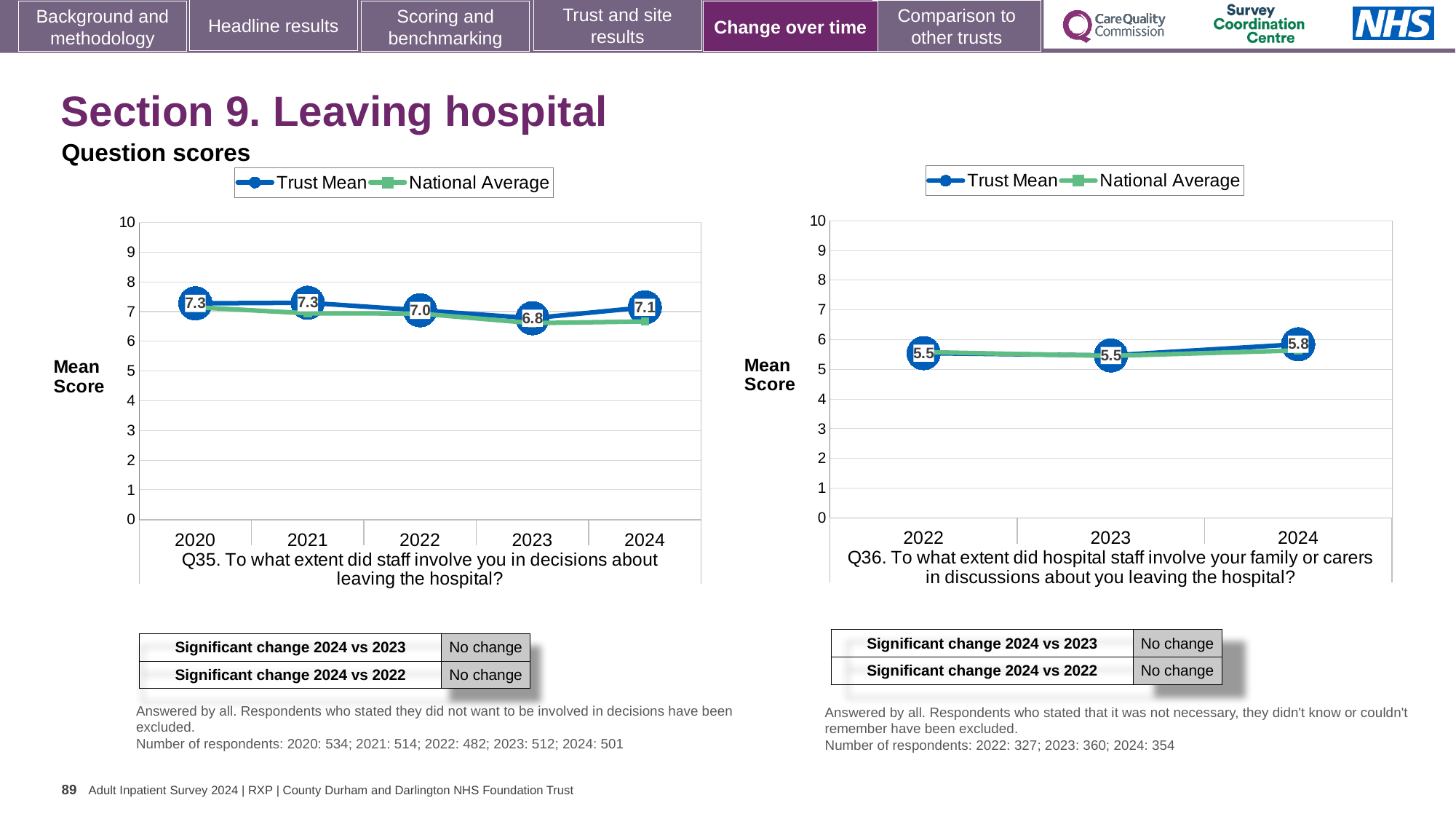
In the Q36 chart on the right, what is the difference between the Trust Mean scores for 2024 and 2022? 0.3 In the Q35 chart on the left, does the Trust Mean score rise or fall from 2021 to 2023? fall In the Q35 chart on the left, what is the difference between the Trust Mean scores for 2021 and 2023? 0.5 How many years are shown on the x axis of the Q36 chart on the right? 3 In the Q35 chart on the left, which year has the lowest Trust Mean score? 2023 In the Q36 chart on the right, which year has the highest Trust Mean score? 2024 In the Q35 chart on the left, is the Trust Mean score higher in 2022 or in 2024? 2024 In the Q35 chart on the left, what is the Trust Mean score for 2020? 7.3 How many series does the legend of the Q35 chart on the left list? 2 In the Q36 chart on the right, is the National Average value for 2024 greater or less than 6? less In the Q36 chart on the right, what is the Trust Mean score for 2024? 5.8 In the Q35 chart on the left, what is the Trust Mean score for 2023? 6.8